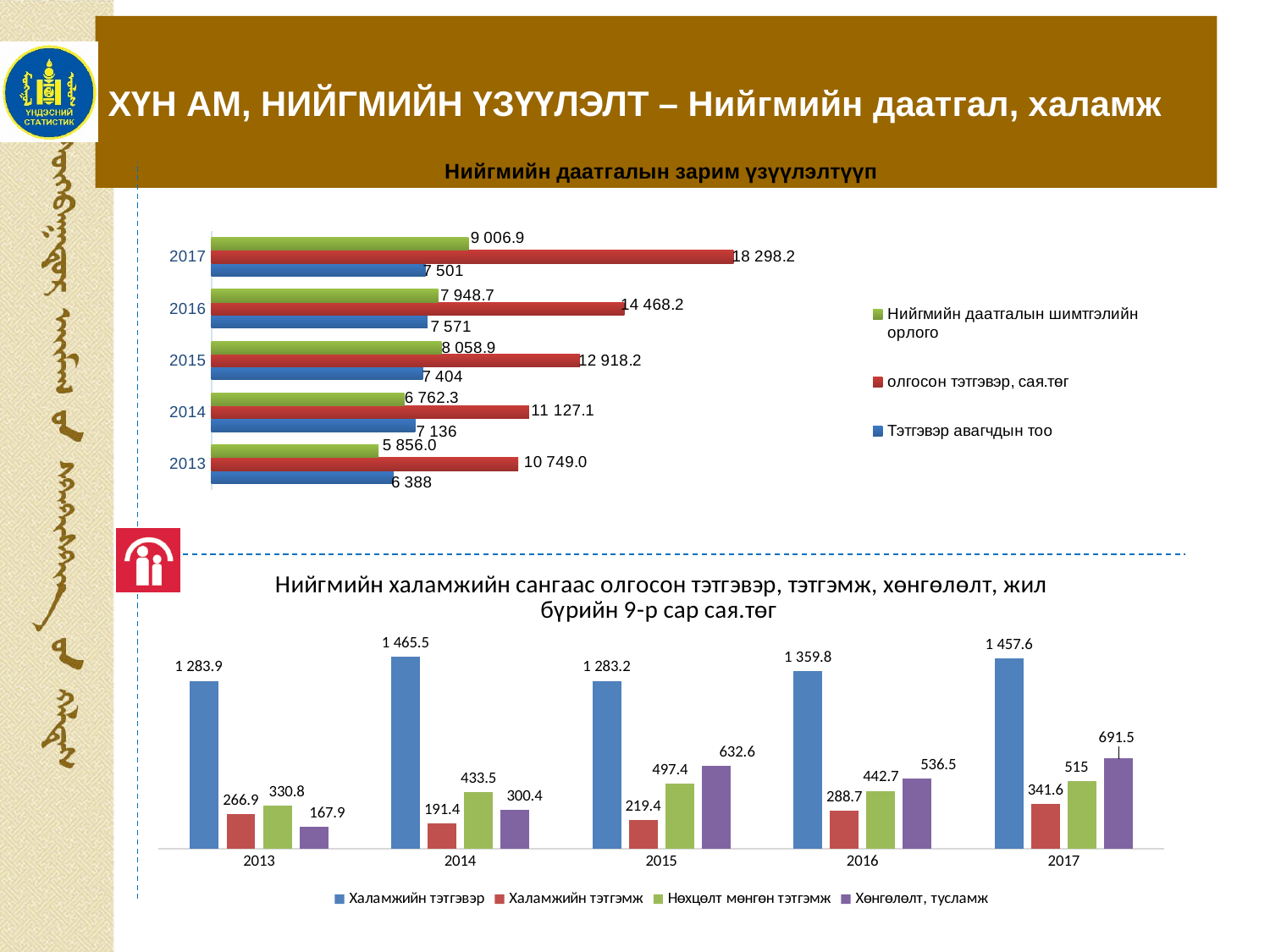
In the top chart (Нийгмийн даатгалын зарим үзүүлэлтүүп), what is the difference between олгосон тэтгэвэр, сая.төг in 2017 and in 2016? 3 830.0 In the top chart (Нийгмийн даатгалын зарим үзүүлэлтүүп), which year has the highest value for Нийгмийн даатгалын шимтгэлийн орлого? 2017 In the top chart (Нийгмийн даатгалын зарим үзүүлэлтүүп), what is the value of олгосон тэтгэвэр, сая.төг for 2017? 18 298.2 In the top chart (Нийгмийн даатгалын зарим үзүүлэлтүүп), how many series does the legend list? 3 What kind of chart is the bottom chart (Нийгмийн халамжийн сангаас олгосон тэтгэвэр...)? bar chart In the bottom chart (Нийгмийн халамжийн сангаас олгосон тэтгэвэр...), which is larger in 2015: Халамжийн тэтгэмж or Нөхцөлт мөнгөн тэтгэмж? Нөхцөлт мөнгөн тэтгэмж In the bottom chart (Нийгмийн халамжийн сангаас олгосон тэтгэвэр...), which year has the lowest value for Хөнгөлөлт, тусламж? 2013 In the top chart (Нийгмийн даатгалын зарим үзүүлэлтүүп), what is the value of Тэтгэвэр авагчдын тоо for 2013? 6 388 In the bottom chart (Нийгмийн халамжийн сангаас олгосон тэтгэвэр...), how many series does the legend list? 4 In the bottom chart (Нийгмийн халамжийн сангаас олгосон тэтгэвэр...), what is the value of Халамжийн тэтгэвэр for 2014? 1 465.5 In the top chart (Нийгмийн даатгалын зарим үзүүлэлтүүп), does олгосон тэтгэвэр, сая.төг rise or fall from 2013 to 2017? rise In the bottom chart (Нийгмийн халамжийн сангаас олгосон тэтгэвэр...), what is the value of Хөнгөлөлт, тусламж for 2017? 691.5